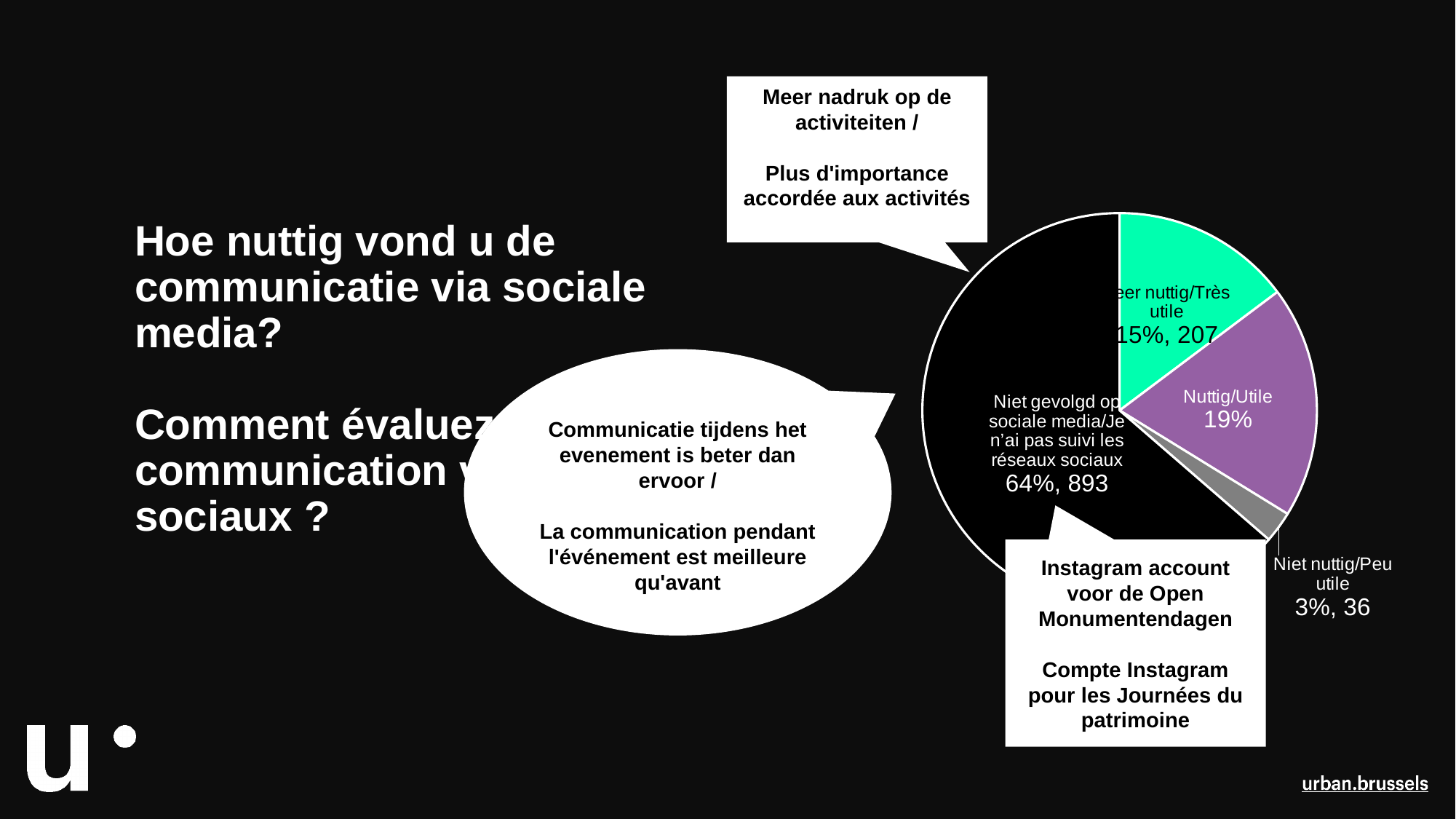
What percentage of the pie does the 'Nuttig/Utile' slice represent? 19% Which slice of the pie chart is the largest? Niet gevolgd op sociale media/Je n'ai pas suivi les réseaux sociaux What percentage of the pie does the 'Zeer nuttig/Très utile' slice represent? 15% How many respondents are in the 'Zeer nuttig/Très utile' slice? 207 Which slice is larger, 'Nuttig/Utile' or 'Zeer nuttig/Très utile'? Nuttig/Utile What percentage of the pie does the 'Niet gevolgd op sociale media/Je n'ai pas suivi les réseaux sociaux' slice represent? 64% What kind of chart is shown on the slide? pie chart How many respondents are in the 'Niet gevolgd op sociale media/Je n'ai pas suivi les réseaux sociaux' slice? 893 Which slice of the pie chart is the smallest? Niet nuttig/Peu utile How many respondents are in the 'Niet nuttig/Peu utile' slice? 36 How many slices does the pie chart have? 4